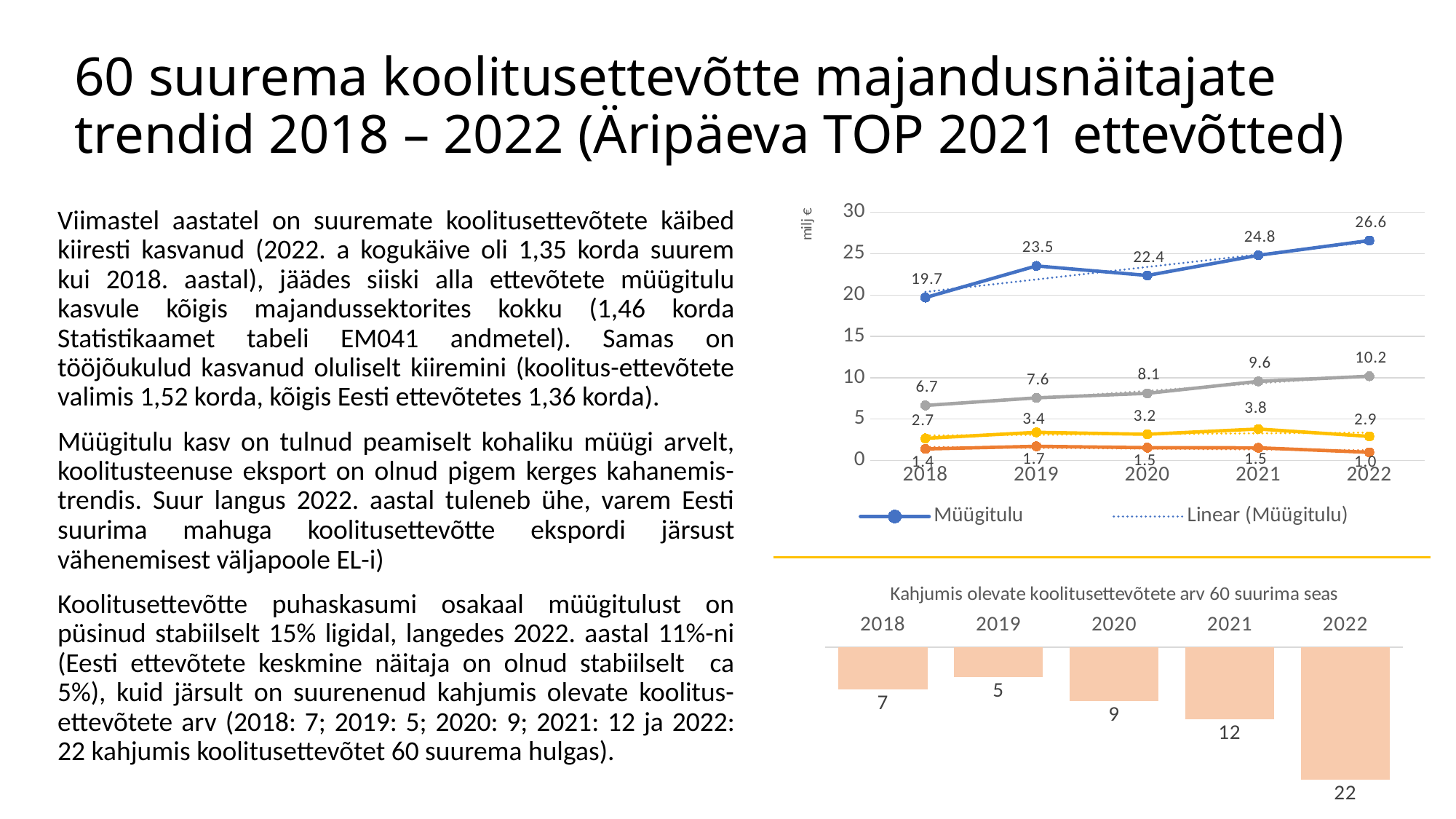
In the chart titled 'Kahjumis olevate koolitusettevõtete arv 60 suurima seas', which year has the lowest value? 2019 In the top-right line chart, in which year is Müügitulu lowest? 2018 In the chart titled 'Kahjumis olevate koolitusettevõtete arv 60 suurima seas', what is the value for 2021? 12 In the top-right line chart, what is the Müügitulu value for 2022? 26.6 In the top-right line chart, what is the difference between the Müügitulu values for 2022 and 2018? 6.9 In the top-right line chart, how many entries does the legend list? 2 In the chart titled 'Kahjumis olevate koolitusettevõtete arv 60 suurima seas', what is the difference between the values for 2022 and 2021? 10 In the top-right line chart, what is the Müügitulu value for 2018? 19.7 What kind of chart is the one titled 'Kahjumis olevate koolitusettevõtete arv 60 suurima seas'? Bar chart In the top-right line chart, in which year is Müügitulu highest? 2022 In the top-right line chart, is Müügitulu higher in 2019 or in 2020? 2019 In the top-right line chart, what unit is shown on the vertical axis label? milj €